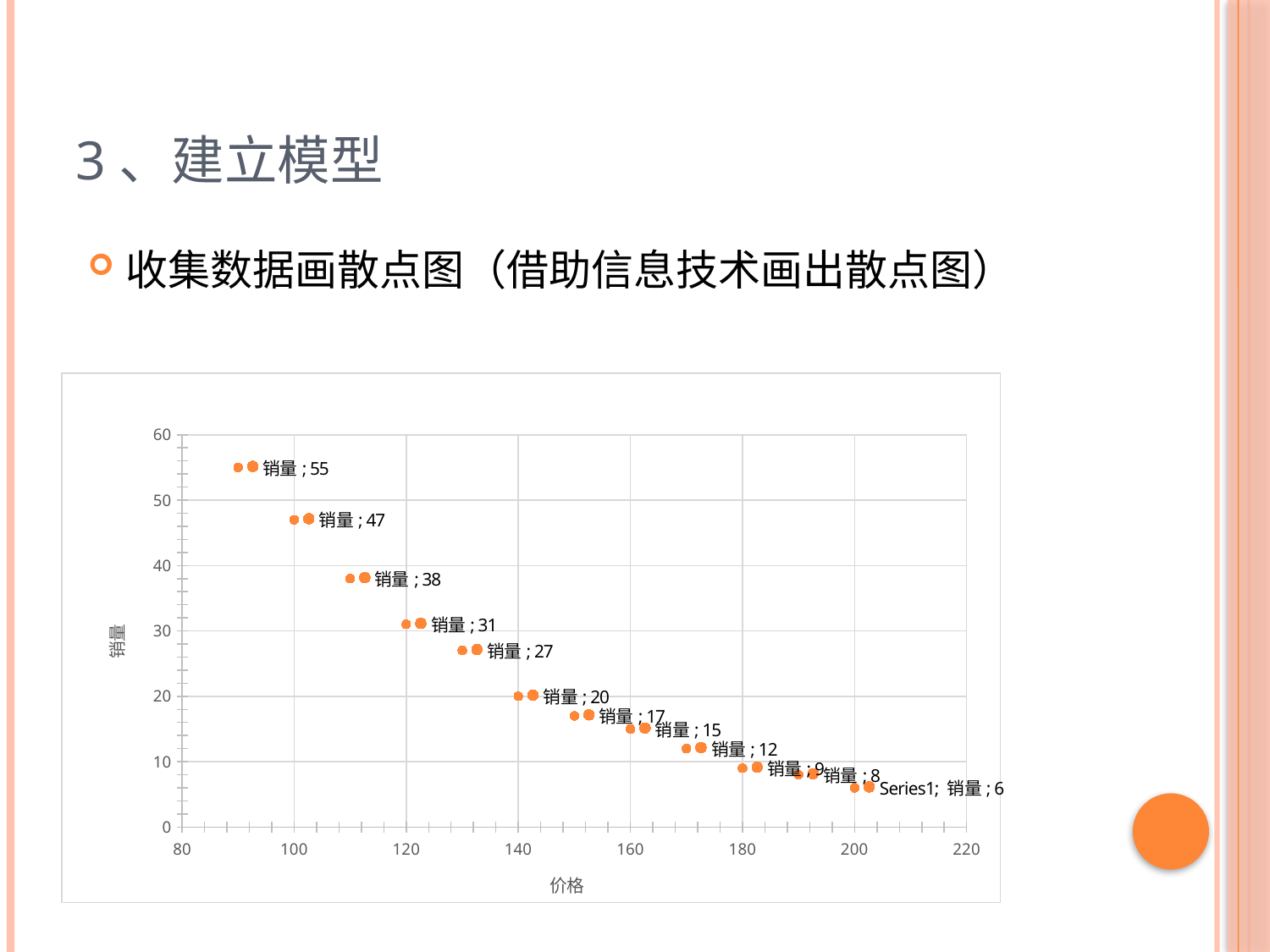
Do the 销量 values rise or fall as 价格 increases along the x axis? fall What is the lowest 销量 value labelled in the chart? 6 What is the 销量 value for the point at price 140? 20 What is the difference between the highest and lowest 销量 values in the chart? 49 What is the 销量 value for the point at price 100? 47 What is the difference between the 销量 values at price 110 and price 120? 7 What is the highest 销量 value labelled in the chart? 55 What is the title of the x axis of the chart? 价格 Which is larger, the 销量 value at price 90 or at price 130? price 90 How many data points are plotted in the chart? 12 What kind of chart is shown on the slide? scatter chart What is the 销量 value for the point at price 200? 6